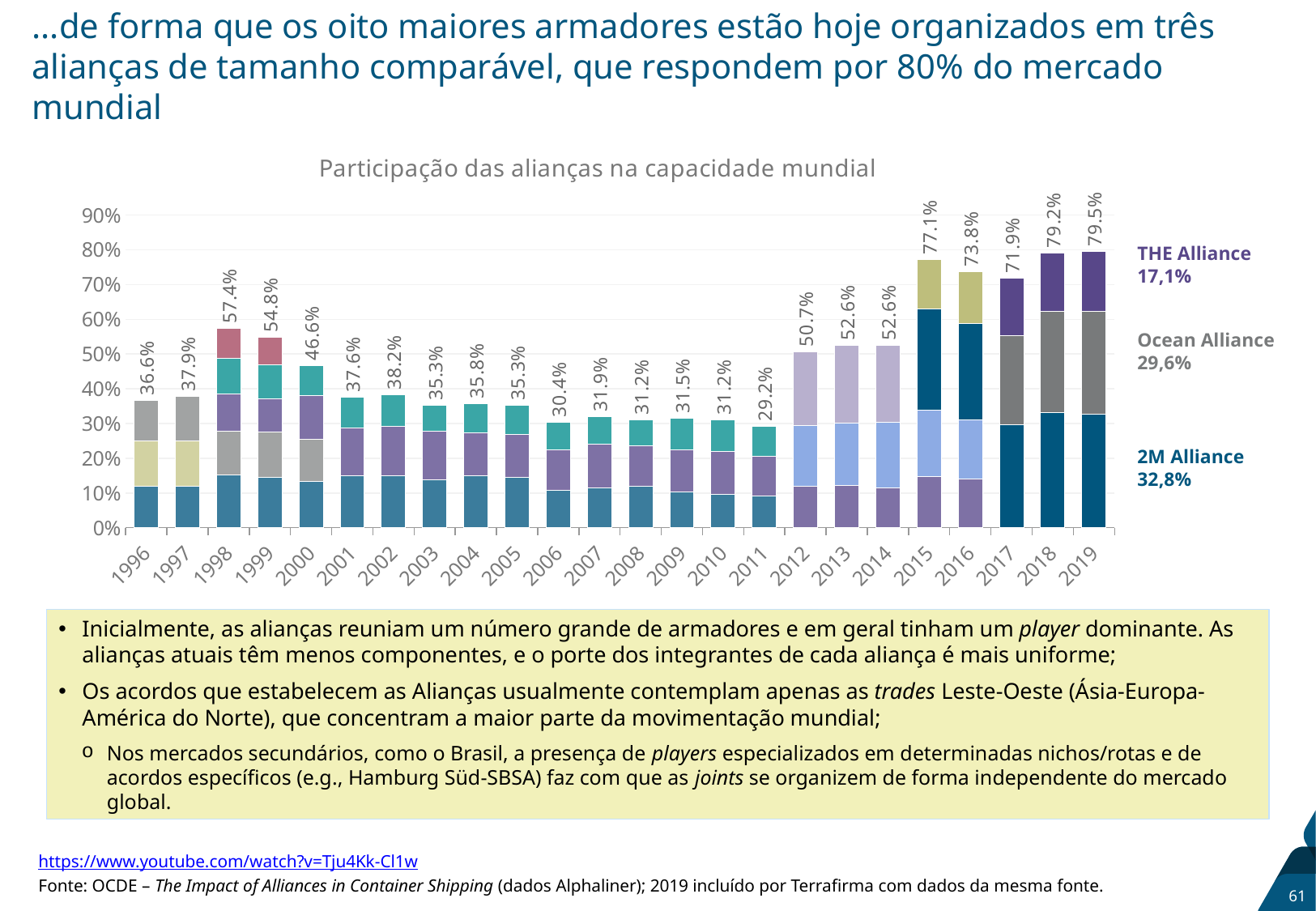
What share is labelled for the 2M Alliance? 32,8% How many years are shown on the x axis of the chart? 24 Which year has the lowest total share of alliances in world capacity? 2011 Which year has the highest total share of alliances in world capacity? 2019 What kind of chart is used to show the alliances' share of world capacity? Stacked bar chart Which year has a larger total share, 2015 or 2016? 2015 Does the total share of alliances rise or fall from 2011 to 2015? Rise What is the total share of alliances in world capacity shown for 2019? 79.5% By how many percentage points does the total for 1998 exceed the total for 1997? 19.5 percentage points What is the total share shown for 1998? 57.4% What share is labelled for THE Alliance? 17,1% What share is labelled for the Ocean Alliance? 29,6%